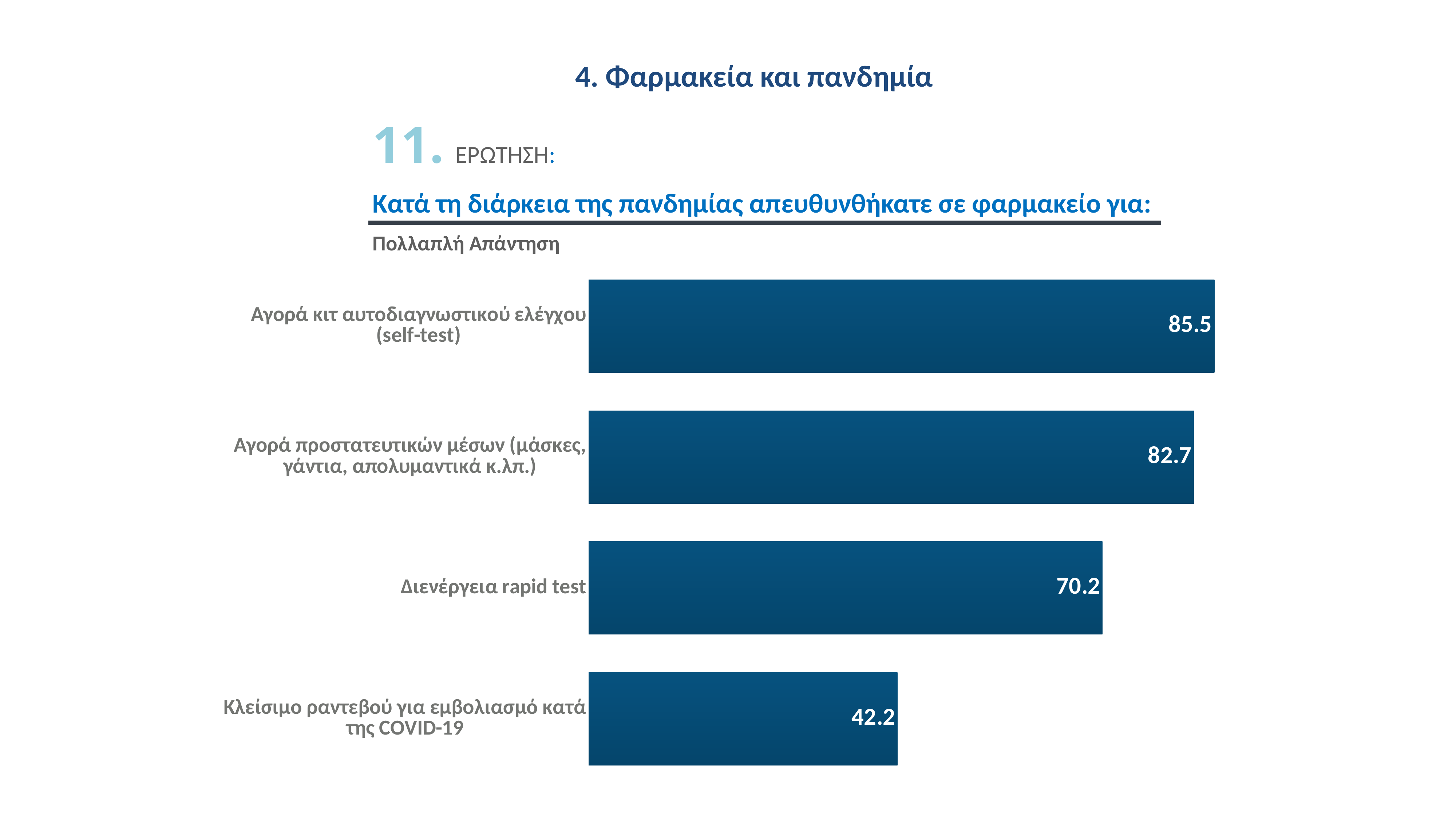
How many categories are shown in the chart? 4 What is the value for 'Κλείσιμο ραντεβού για εμβολιασμό κατά της COVID-19'? 42.2 What is the difference between the values for 'Αγορά κιτ αυτοδιαγνωστικού ελέγχου (self-test)' and 'Κλείσιμο ραντεβού για εμβολιασμό κατά της COVID-19'? 43.3 Which category has the lowest value? Κλείσιμο ραντεβού για εμβολιασμό κατά της COVID-19 What is the value for 'Αγορά προστατευτικών μέσων (μάσκες, γάντια, απολυμαντικά κ.λπ.)'? 82.7 What is the value for 'Διενέργεια rapid test'? 70.2 Which is larger: the value for 'Διενέργεια rapid test' or the value for 'Κλείσιμο ραντεβού για εμβολιασμό κατά της COVID-19'? Διενέργεια rapid test Which category has the highest value? Αγορά κιτ αυτοδιαγνωστικού ελέγχου (self-test) What kind of chart is shown on the slide? Bar chart What is the question text shown above the chart? Κατά τη διάρκεια της πανδημίας απευθυνθήκατε σε φαρμακείο για: What is the difference between the values for 'Αγορά προστατευτικών μέσων (μάσκες, γάντια, απολυμαντικά κ.λπ.)' and 'Διενέργεια rapid test'? 12.5 What is the value for 'Αγορά κιτ αυτοδιαγνωστικού ελέγχου (self-test)'? 85.5